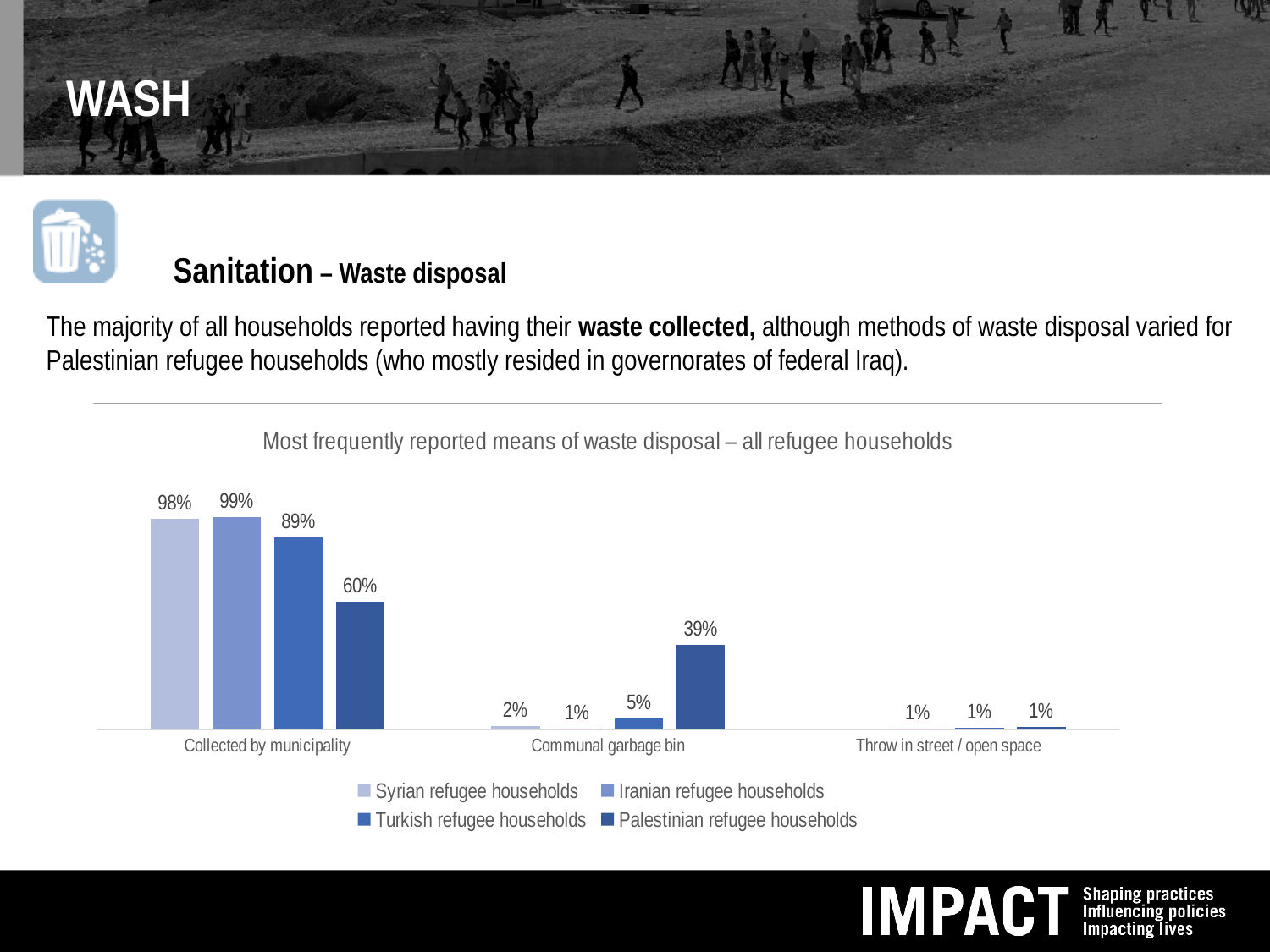
How many series does the legend list? 4 What value is shown for Turkish refugee households under Communal garbage bin? 5% What percentage of Iranian refugee households reported waste collected by municipality? 99% For Communal garbage bin, which is larger: Palestinian refugee households or Turkish refugee households? Palestinian refugee households Which household group has the highest value for Collected by municipality? Iranian refugee households What value is shown for Syrian refugee households under Communal garbage bin? 2% Which household group has the lowest value for Collected by municipality? Palestinian refugee households How many waste disposal categories are shown on the x axis? 3 What is the title of the chart? Most frequently reported means of waste disposal – all refugee households What is the difference between Syrian and Palestinian refugee households for Collected by municipality? 38 percentage points What percentage of Palestinian refugee households reported waste collected by municipality? 60% What kind of chart is shown on the slide? Bar chart